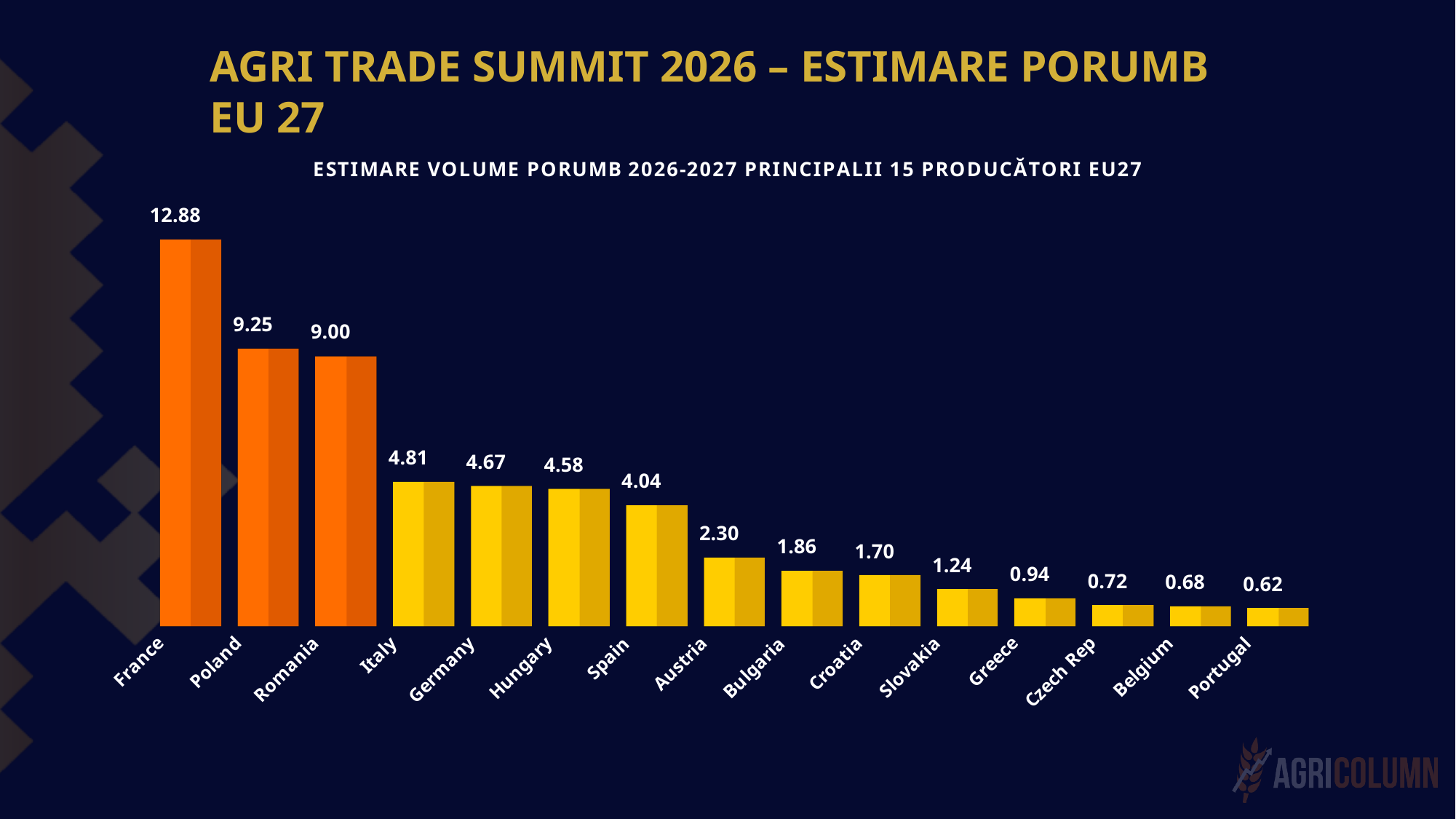
What is the value for France? 12.88 Which has a larger value, Hungary or Austria? Hungary What kind of chart is shown on the slide? Bar chart What is the value for Slovakia? 1.24 Do the values rise or fall from left to right along the x axis? Fall How many countries are shown in the chart? 15 What is the title of the chart? ESTIMARE VOLUME PORUMB 2026-2027 PRINCIPALII 15 PRODUCĂTORI EU27 What is the difference between the values for Poland and Romania? 0.25 What is the difference between the values for Italy and Spain? 0.77 Which country has the lowest value? Portugal Which country has the highest value? France What is the value for Germany? 4.67